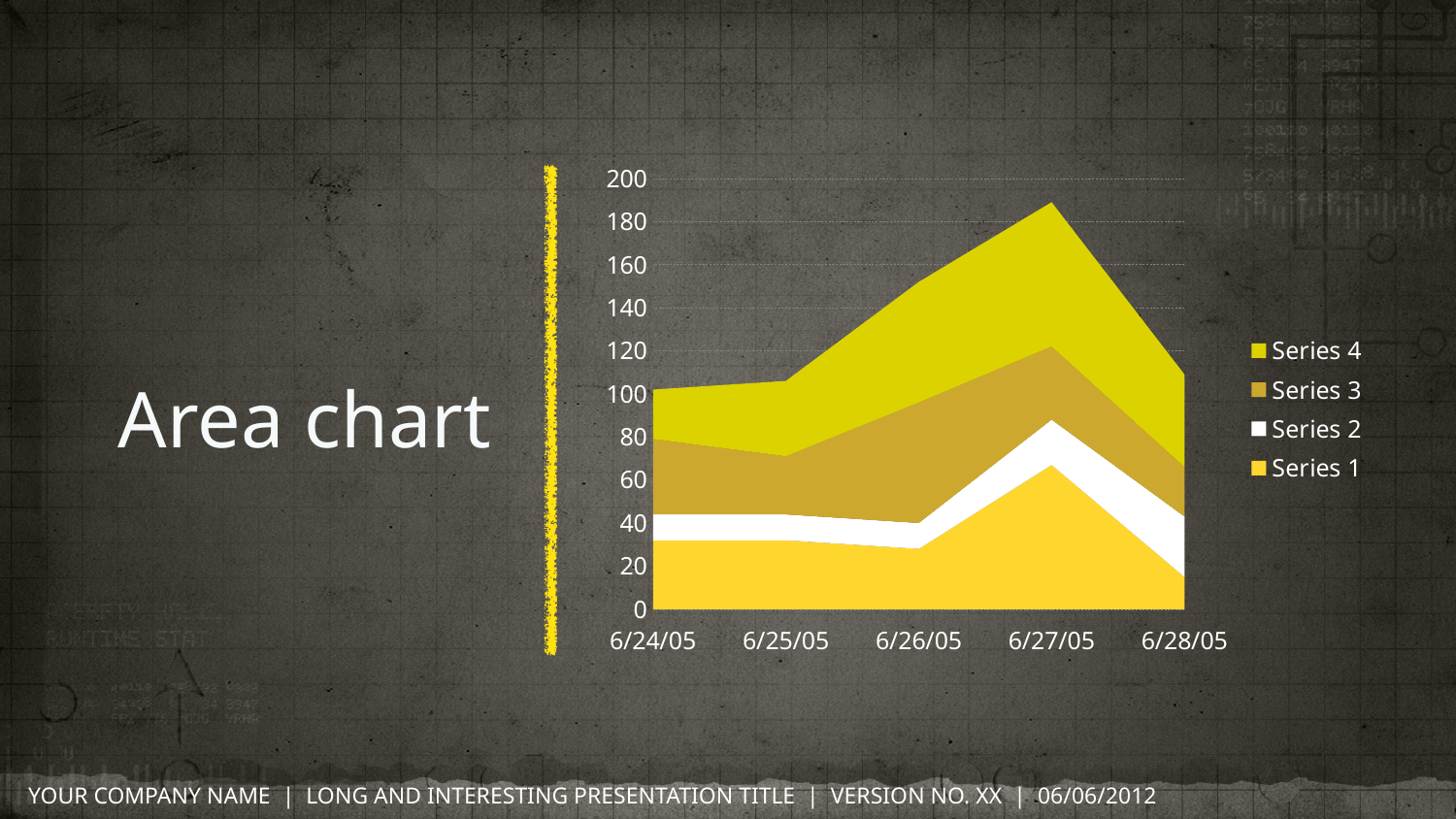
On which date is the value for Series 1 lowest? 6/28/05 Does the stacked total rise or fall from 6/24/05 to 6/27/05? rise Is the stacked total on 6/26/05 greater or less than 140? greater Is the stacked total on 6/27/05 greater or less than 180? greater On which date does the stacked total reach its highest point? 6/27/05 On which date is the value for Series 1 highest? 6/27/05 How many dates are shown along the x axis? 5 What is the title of the slide containing the chart? Area chart What kind of chart is shown on the slide? area chart Which series is listed first in the legend? Series 4 Is the value for Series 1 on 6/28/05 greater or less than 20? less How many series does the legend list? 4